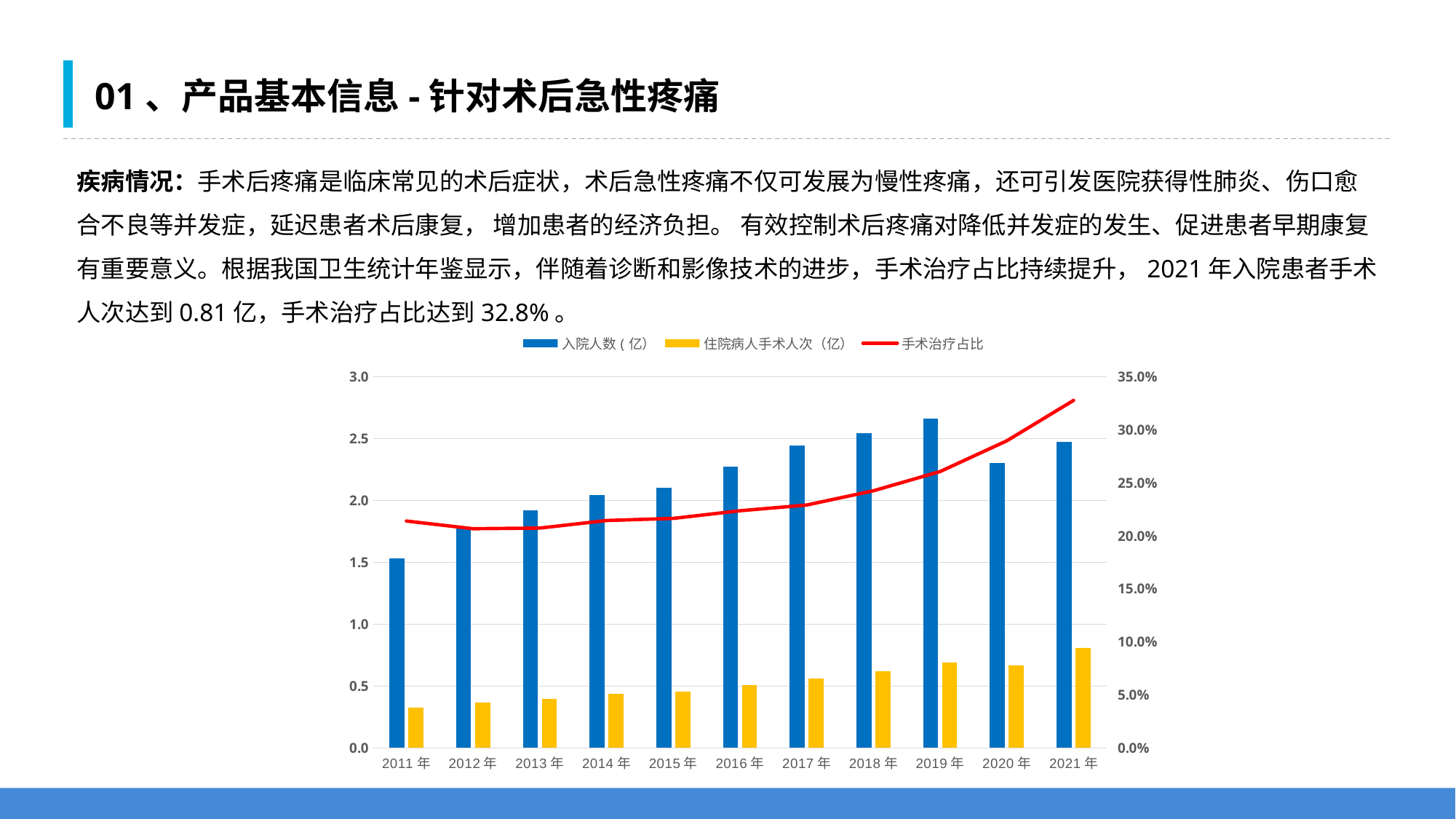
Is the value for 入院人数 (亿) in 2020 年 greater or less than 2.5? less How many years are shown on the x axis of the chart? 11 Is the value for 手术治疗占比 in 2021 年 greater or less than 30.0%? greater Which year has the highest value for 手术治疗占比? 2021 年 Which is larger, 入院人数 (亿) in 2019 年 or in 2020 年? 2019 年 What kind of chart is shown on the slide? Bar chart with a line series How many series does the chart legend list? 3 Which year has the highest value for 住院病人手术人次 (亿)? 2021 年 Does 手术治疗占比 generally rise or fall from 2013 年 to 2021 年? rise Is the value for 入院人数 (亿) in 2019 年 greater or less than 2.5? greater Which year has the highest value for 入院人数 (亿)? 2019 年 Which year has the lowest value for 入院人数 (亿)? 2011 年